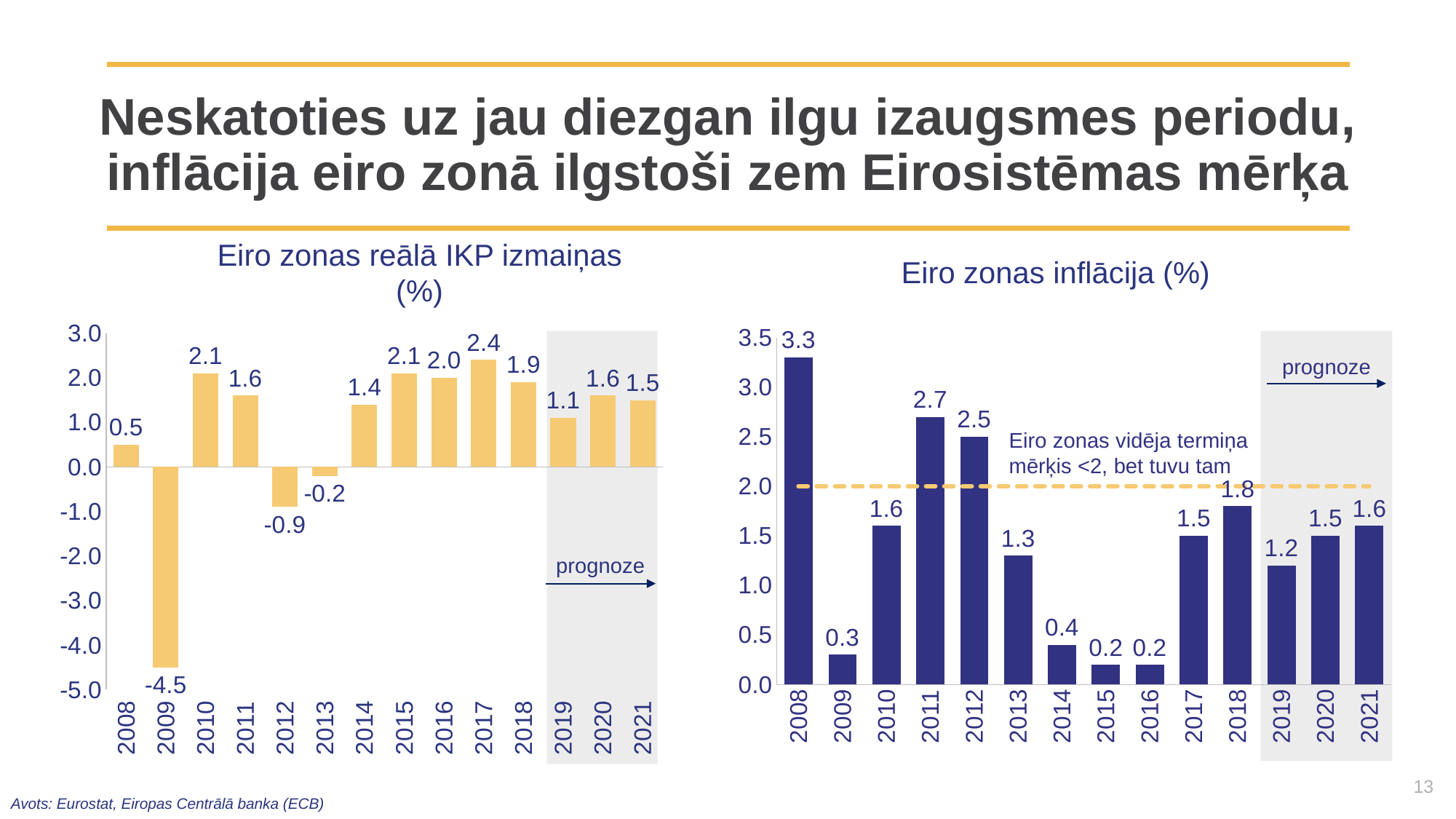
In the chart titled "Eiro zonas inflācija (%)", what is the value for 2011? 2.7 What kind of chart is the chart titled "Eiro zonas inflācija (%)"? bar chart In the chart titled "Eiro zonas inflācija (%)", which is larger, the value for 2012 or the value for 2013? 2012 In the chart titled "Eiro zonas reālā IKP izmaiņas (%)", how many years are shown on the x axis? 14 In the chart titled "Eiro zonas inflācija (%)", what is the value for 2021? 1.6 In the chart titled "Eiro zonas inflācija (%)", what level does the dashed horizontal line mark? 2.0 In the chart titled "Eiro zonas reālā IKP izmaiņas (%)", which year has the highest value? 2017 In the chart titled "Eiro zonas inflācija (%)", which year has the highest value? 2008 In the chart titled "Eiro zonas reālā IKP izmaiņas (%)", what is the value for 2009? -4.5 In the chart titled "Eiro zonas reālā IKP izmaiņas (%)", which year has the lowest value? 2009 In the chart titled "Eiro zonas inflācija (%)", what is the difference between the values for 2008 and 2009? 3.0 In the chart titled "Eiro zonas reālā IKP izmaiņas (%)", what is the difference between the values for 2017 and 2018? 0.5